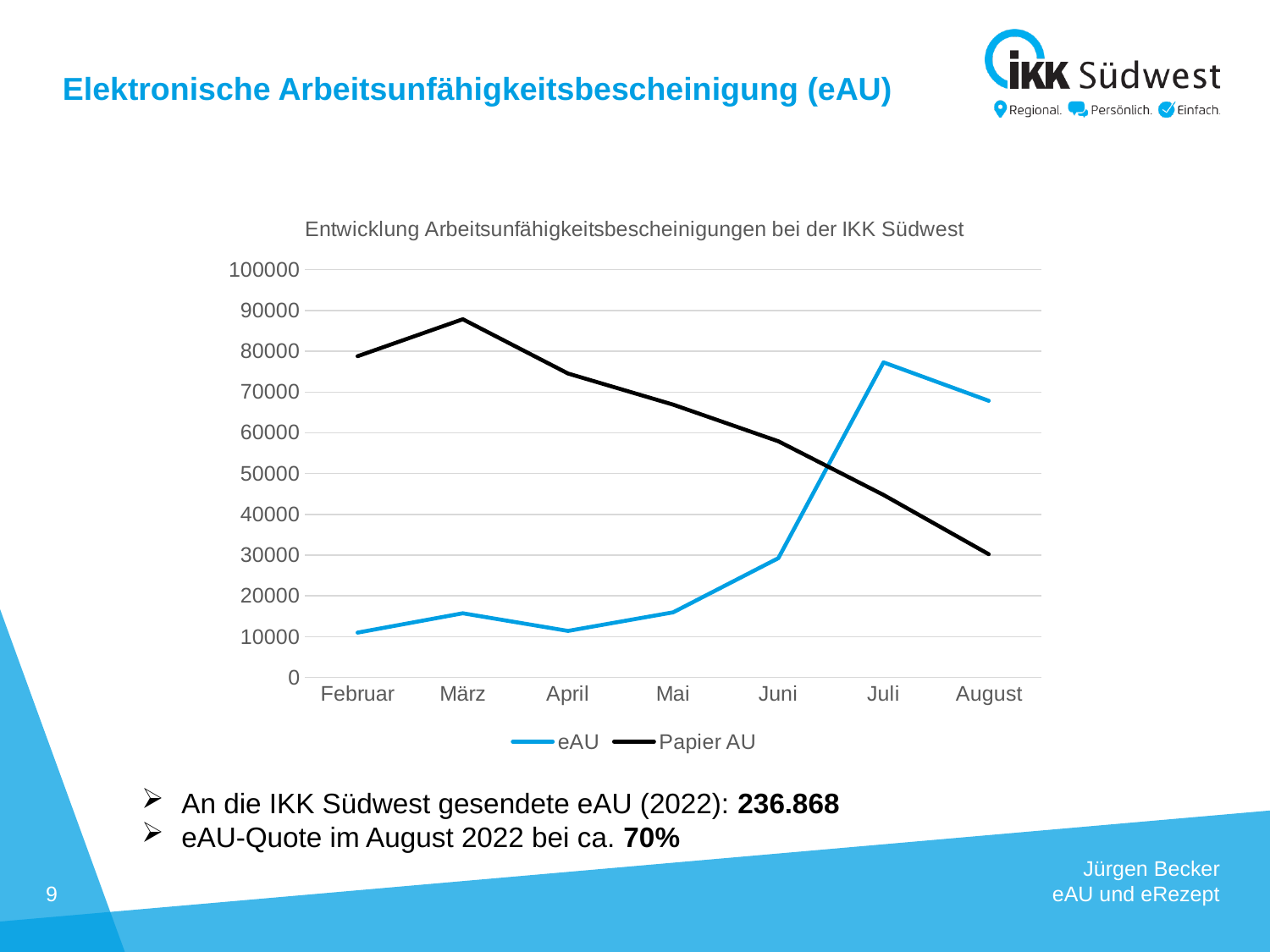
Is the eAU value for Juni greater or less than 20000? greater In which month is the Papier AU value highest? März What is the title of the chart? Entwicklung Arbeitsunfähigkeitsbescheinigungen bei der IKK Südwest Is the Papier AU value for August greater or less than 40000? less What kind of chart is shown on the slide? line chart How many months are shown on the x axis? 7 In which month is the eAU value highest? Juli How many series does the legend list? 2 Does the Papier AU series rise or fall from März to August? fall In Februar, which series has the larger value, eAU or Papier AU? Papier AU In Juli, which series has the larger value, eAU or Papier AU? eAU In which month is the Papier AU value lowest? August